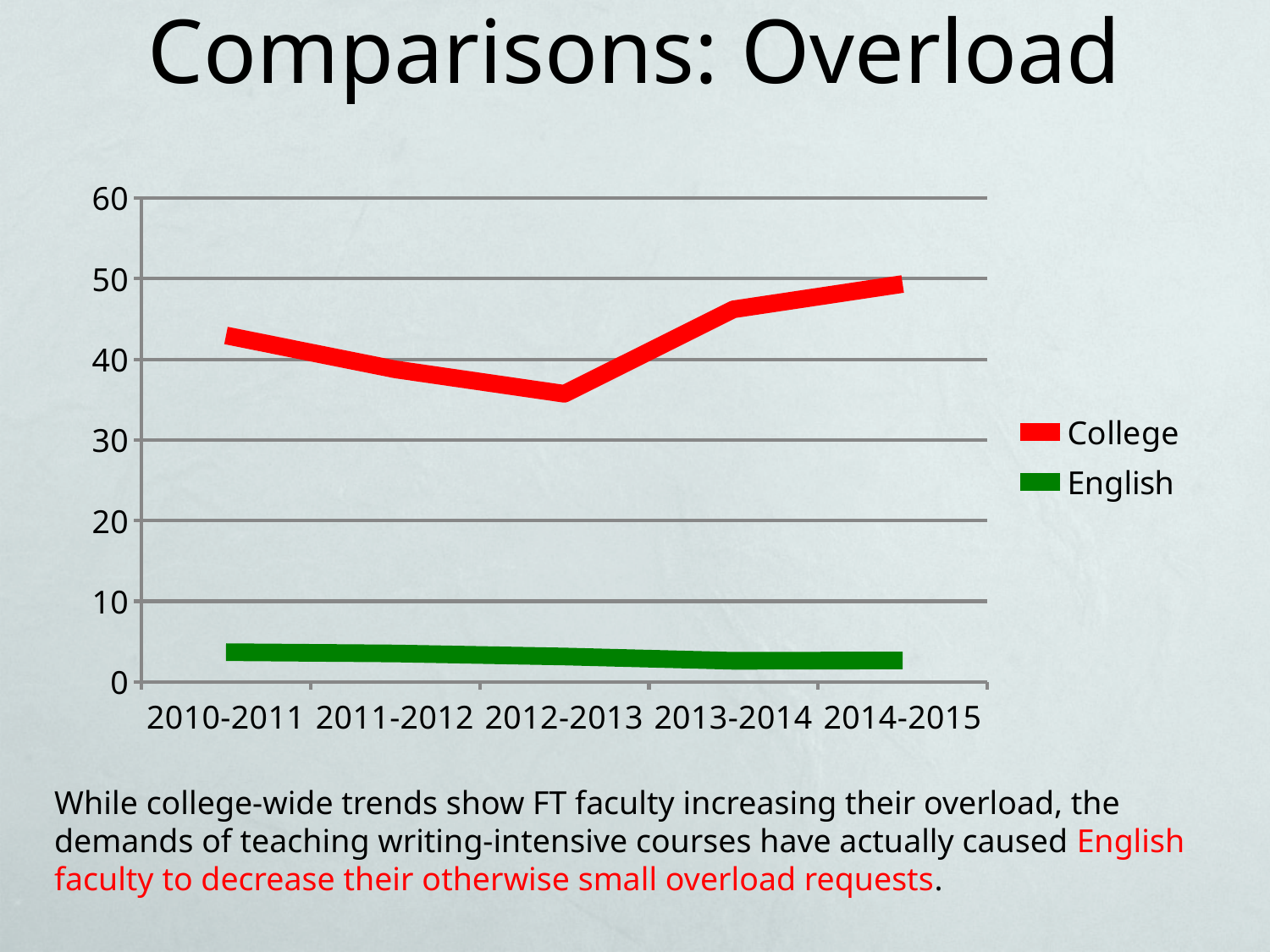
In 2012-2013, which series has the larger value, College or English? College How many series does the legend list? 2 What kind of chart is shown on the slide? line chart In which year is the College series at its lowest? 2012-2013 Is the College value for 2012-2013 greater or less than 40? less What colour is the College line? red How many academic years are plotted along the x axis? 5 Does the English series rise or fall from 2010-2011 to 2014-2015? fall In which year is the College series at its highest? 2014-2015 Is the College value for 2013-2014 greater or less than 40? greater Is the English value for 2010-2011 greater or less than 10? less